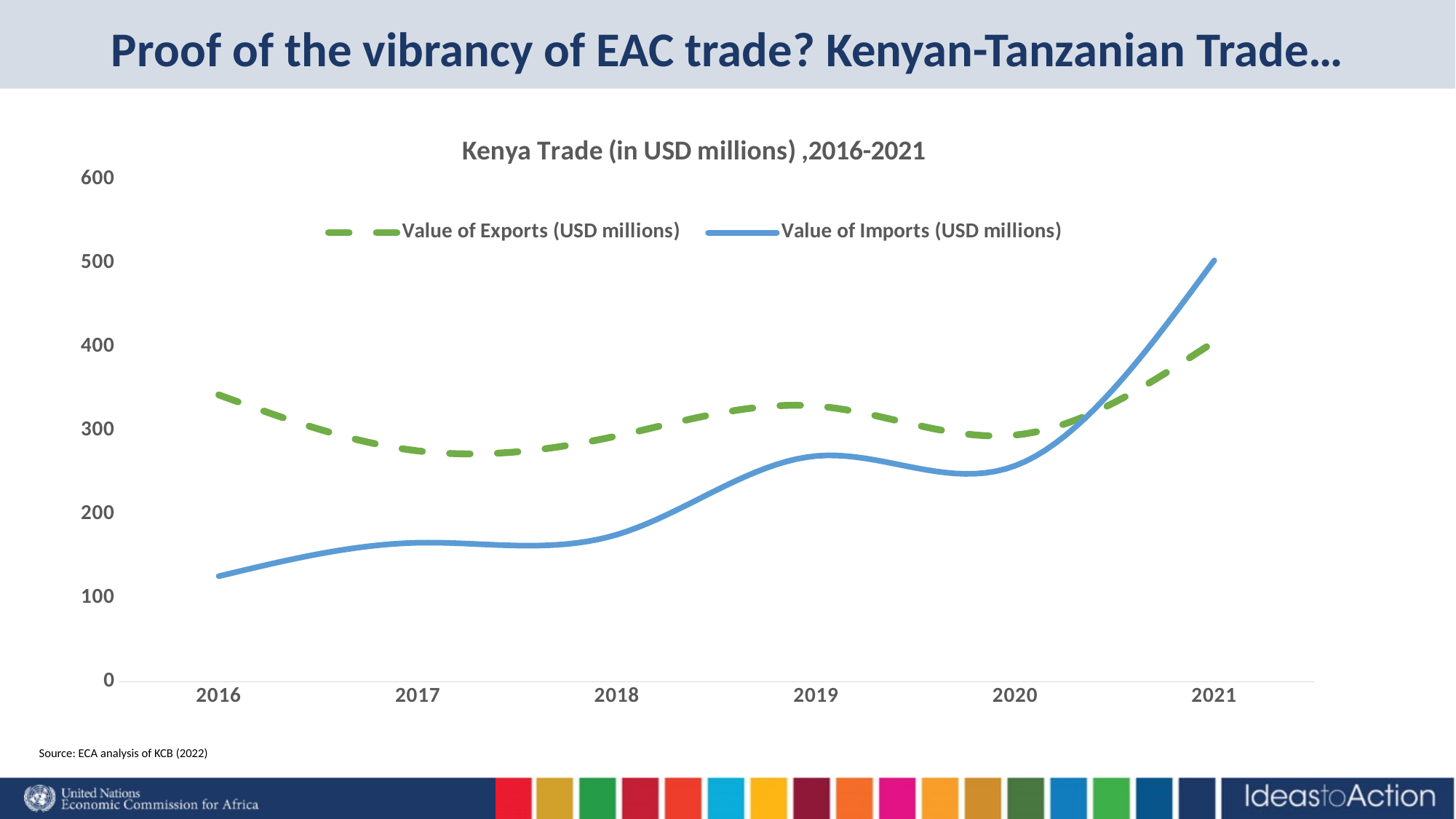
In which year is the Value of Imports lowest? 2016 What is the title of the chart? Kenya Trade (in USD millions) ,2016-2021 Is the Value of Imports in 2016 greater or less than 200? less Is the Value of Exports in 2021 greater or less than 300? greater In 2016, which is larger: the Value of Exports or the Value of Imports? Value of Exports What kind of chart is shown on the slide? line chart In which year is the Value of Exports lowest? 2017 In 2021, which is larger: the Value of Exports or the Value of Imports? Value of Imports In which year is the Value of Imports highest? 2021 How many years are plotted along the x axis? 6 How many series does the legend list? 2 In which year is the Value of Exports highest? 2021